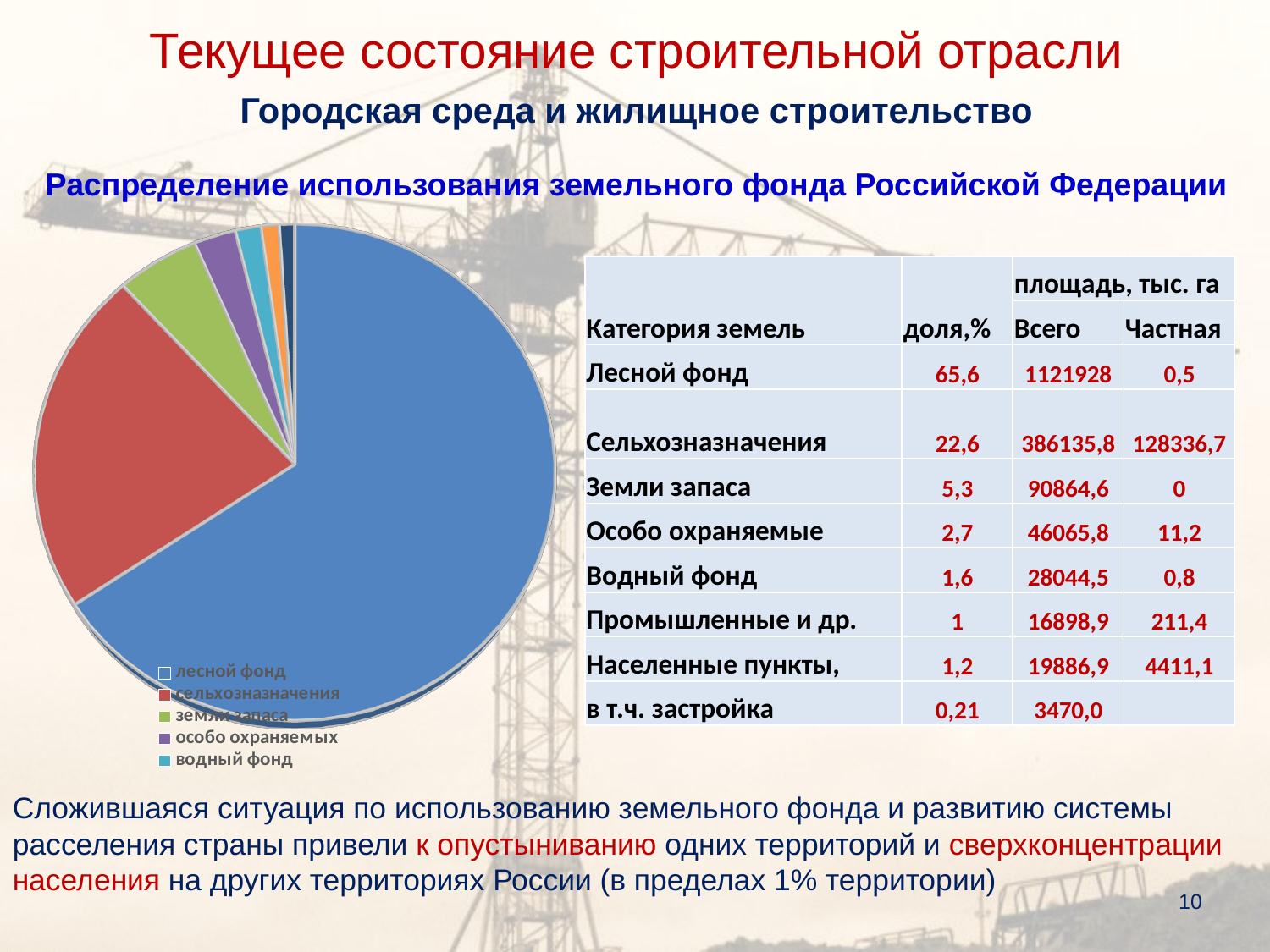
Which category has the largest slice in the pie chart? лесной фонд According to the table next to the pie chart, what is the доля,% for Лесной фонд? 65,6 What colour is the largest slice of the pie chart? blue How many entries are listed in the pie chart's legend? 5 What kind of chart is shown on the slide? pie chart How many slices does the pie chart have? 7 According to the table next to the pie chart, what is the доля,% for Сельхозназначения? 22,6 Among the five categories in the legend, which has the smallest slice in the pie chart? водный фонд Which slice is larger in the pie chart, сельхозназначения or земли запаса? сельхозназначения Does the лесной фонд slice take up greater or less than half of the pie? greater Which slice is larger in the pie chart, особо охраняемых or водный фонд? особо охраняемых What is the title above the pie chart? Распределение использования земельного фонда Российской Федерации